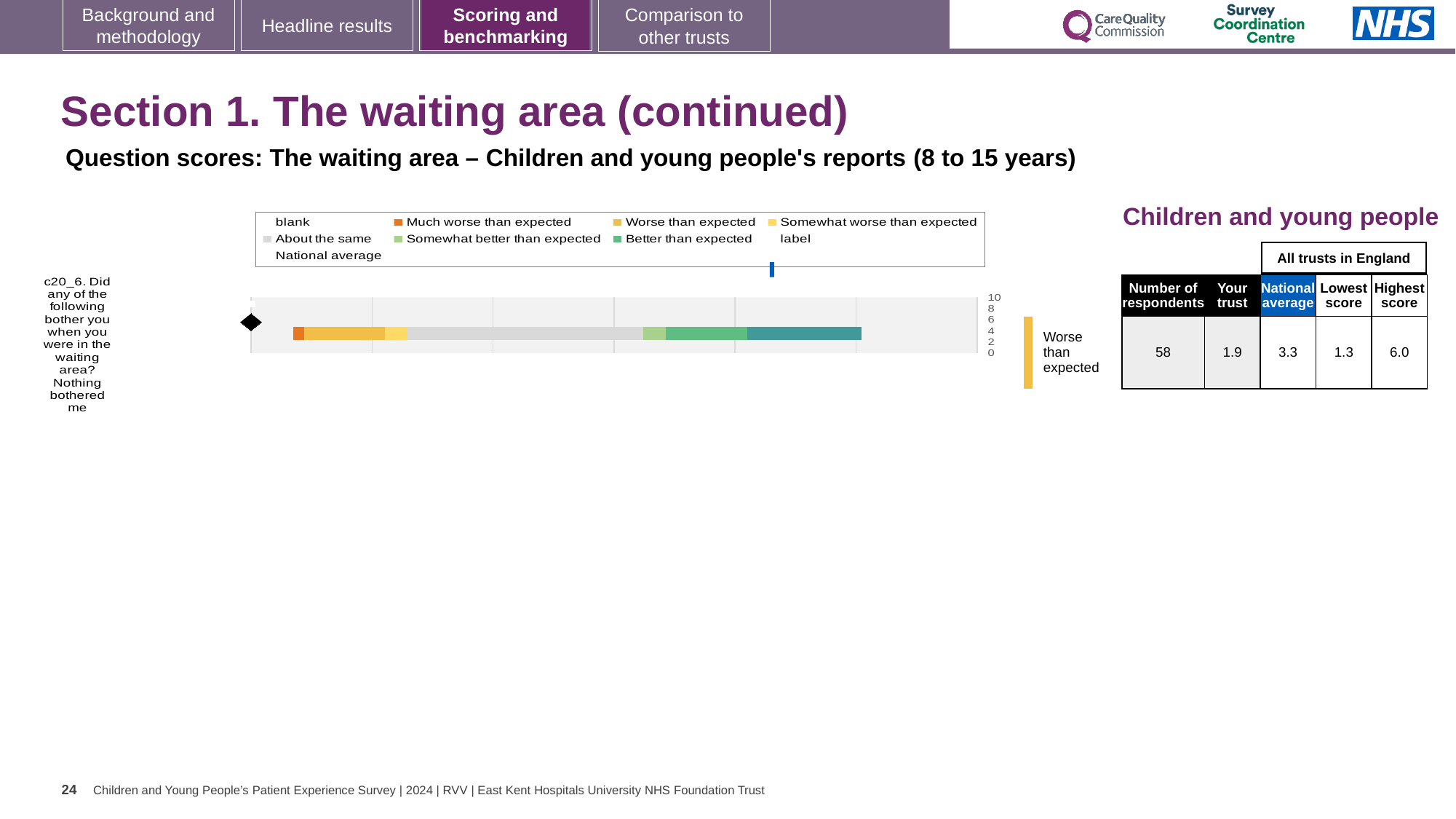
What kind of chart is used to show the question score for c20_6? bar chart What is the difference between the highest and lowest scores for question c20_6? 4.7 What benchmark label is shown to the right of the chart for question c20_6? Worse than expected How many entries does the chart legend list? 9 How many questions (categories) are plotted in the chart? 1 How many respondents answered question c20_6? 58 What is the lowest score among all trusts in England for question c20_6? 1.3 What is the highest score among all trusts in England for question c20_6? 6.0 Which is larger for question c20_6, the trust's score or the national average? national average What colour does the legend use for 'Much worse than expected'? orange What is the 'Your trust' score for question c20_6? 1.9 What is the national average score for question c20_6? 3.3